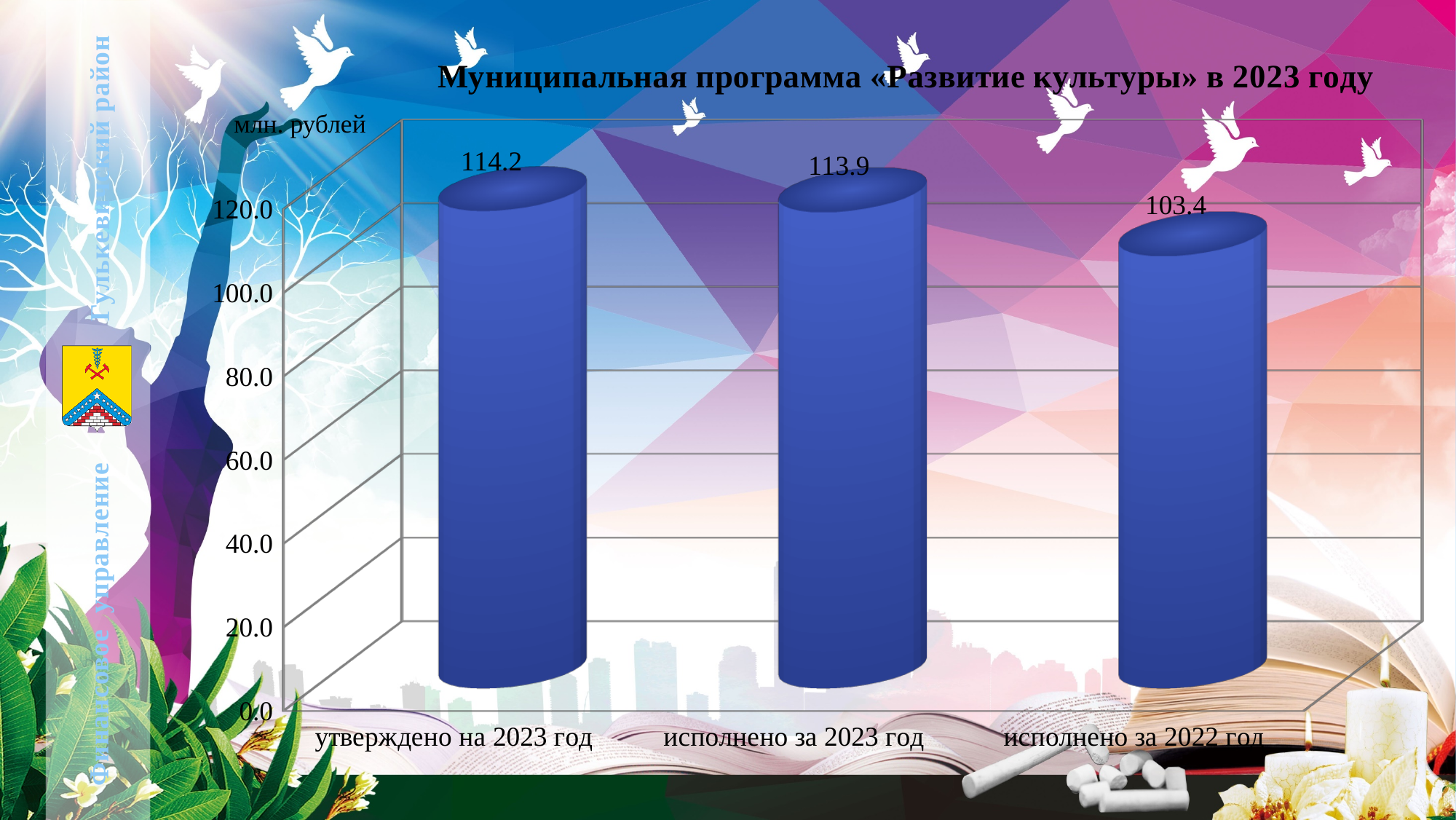
What unit is indicated on the vertical axis of the chart? млн. рублей What is the difference between «исполнено за 2023 год» and «исполнено за 2022 год»? 10.5 Which is larger: «исполнено за 2023 год» or «исполнено за 2022 год»? исполнено за 2023 год What kind of chart is shown on the slide? bar chart What is the value for «исполнено за 2022 год»? 103.4 What is the value for «утверждено на 2023 год»? 114.2 How many categories are shown in the chart? 3 Which category has the highest value? утверждено на 2023 год Is the value for «исполнено за 2022 год» greater or less than 100.0? greater What is the difference between «утверждено на 2023 год» and «исполнено за 2023 год»? 0.3 What is the value for «исполнено за 2023 год»? 113.9 Which category has the lowest value? исполнено за 2022 год